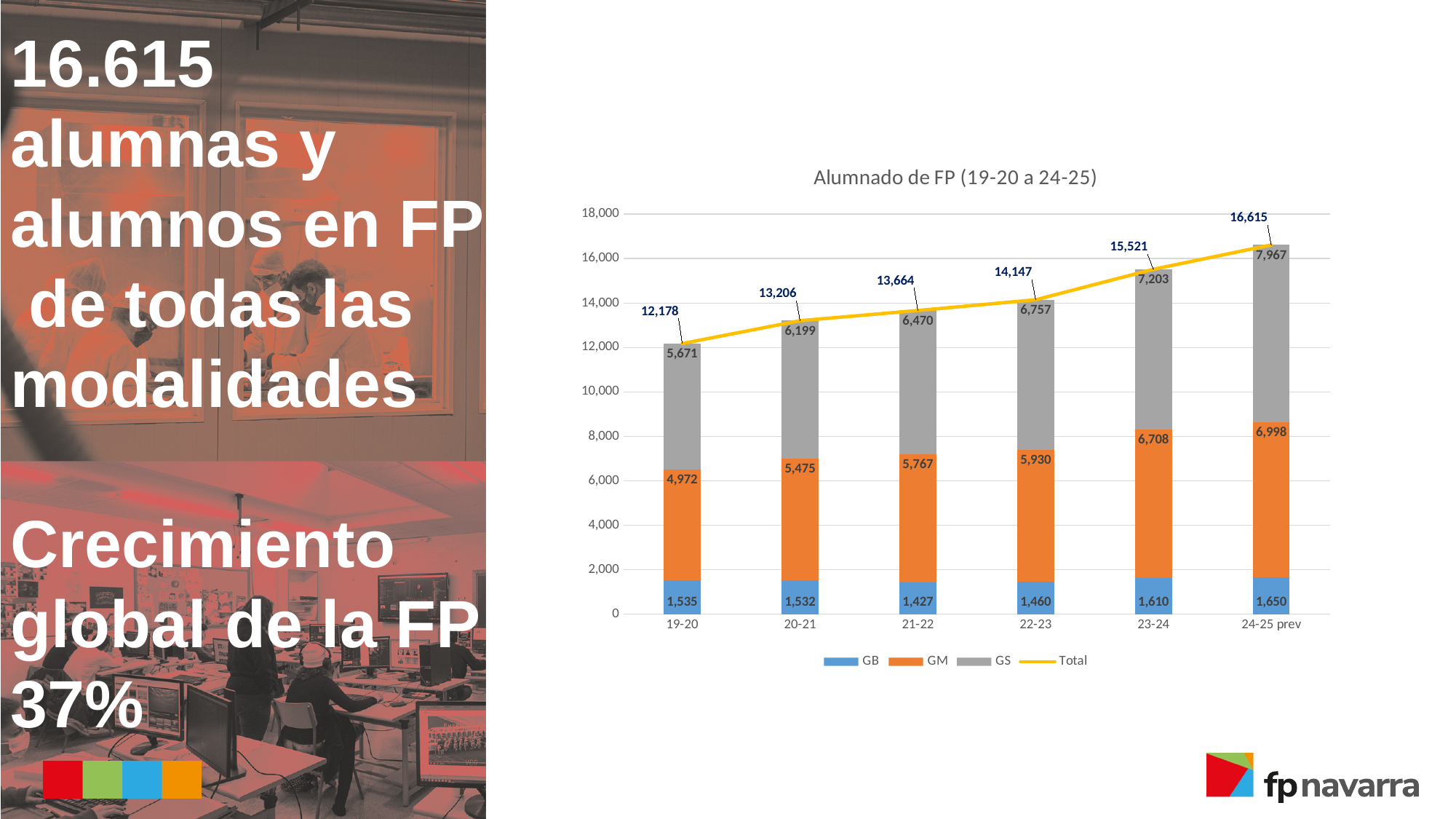
How many academic years (categories) are shown on the x axis? 6 What is the difference between the Total for 24-25 prev and the Total for 19-20? 4,437 In which year is the GB value lowest? 21-22 What is the Total value for 19-20? 12,178 In which year is the Total highest? 24-25 prev What kind of chart is shown on the slide? Stacked bar chart with a line What is the GS value for 21-22? 6,470 How many series does the legend list? 4 Which is larger, the GS value for 22-23 or the GM value for 22-23? GS value for 22-23 Does the Total rise or fall from 19-20 to 24-25 prev? Rise What is the title of the chart? Alumnado de FP (19-20 a 24-25) What is the GM value for 23-24? 6,708